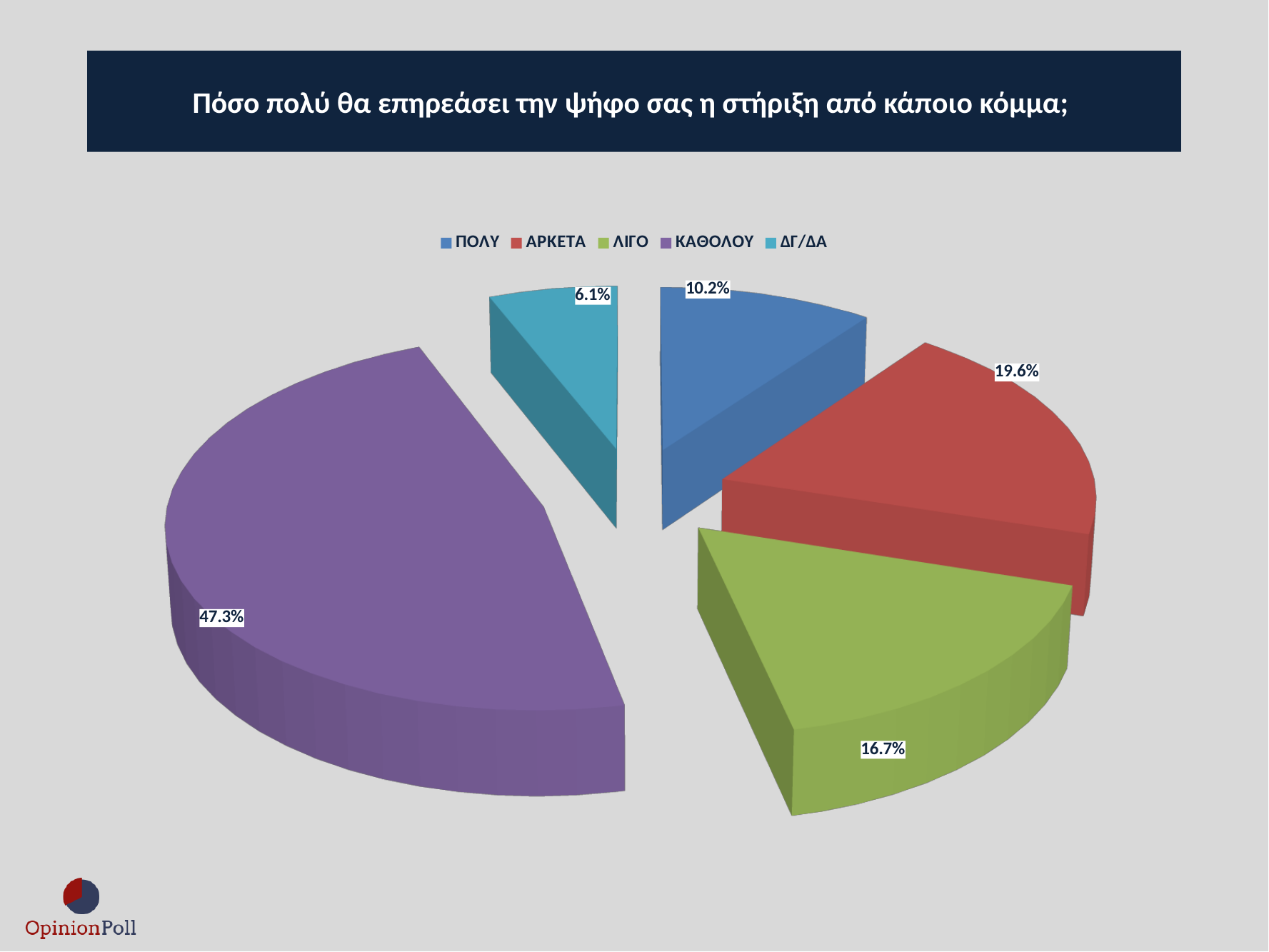
What percentage of the pie is labelled ΠΟΛΥ? 10.2% What is the difference in percentage points between ΑΡΚΕΤΑ and ΛΙΓΟ? 2.9 Which is larger, the ΠΟΛΥ slice or the ΑΡΚΕΤΑ slice? ΑΡΚΕΤΑ What kind of chart is shown on the slide? Pie chart What percentage of the pie is labelled ΔΓ/ΔΑ? 6.1% What percentage of the pie is labelled ΚΑΘΟΛΟΥ? 47.3% Which category has the smallest slice of the pie? ΔΓ/ΔΑ What colour is the ΚΑΘΟΛΟΥ slice? Purple How many slices does the pie chart have? 5 What percentage of the pie is labelled ΑΡΚΕΤΑ? 19.6% What percentage of the pie is labelled ΛΙΓΟ? 16.7% Which category has the largest slice of the pie? ΚΑΘΟΛΟΥ